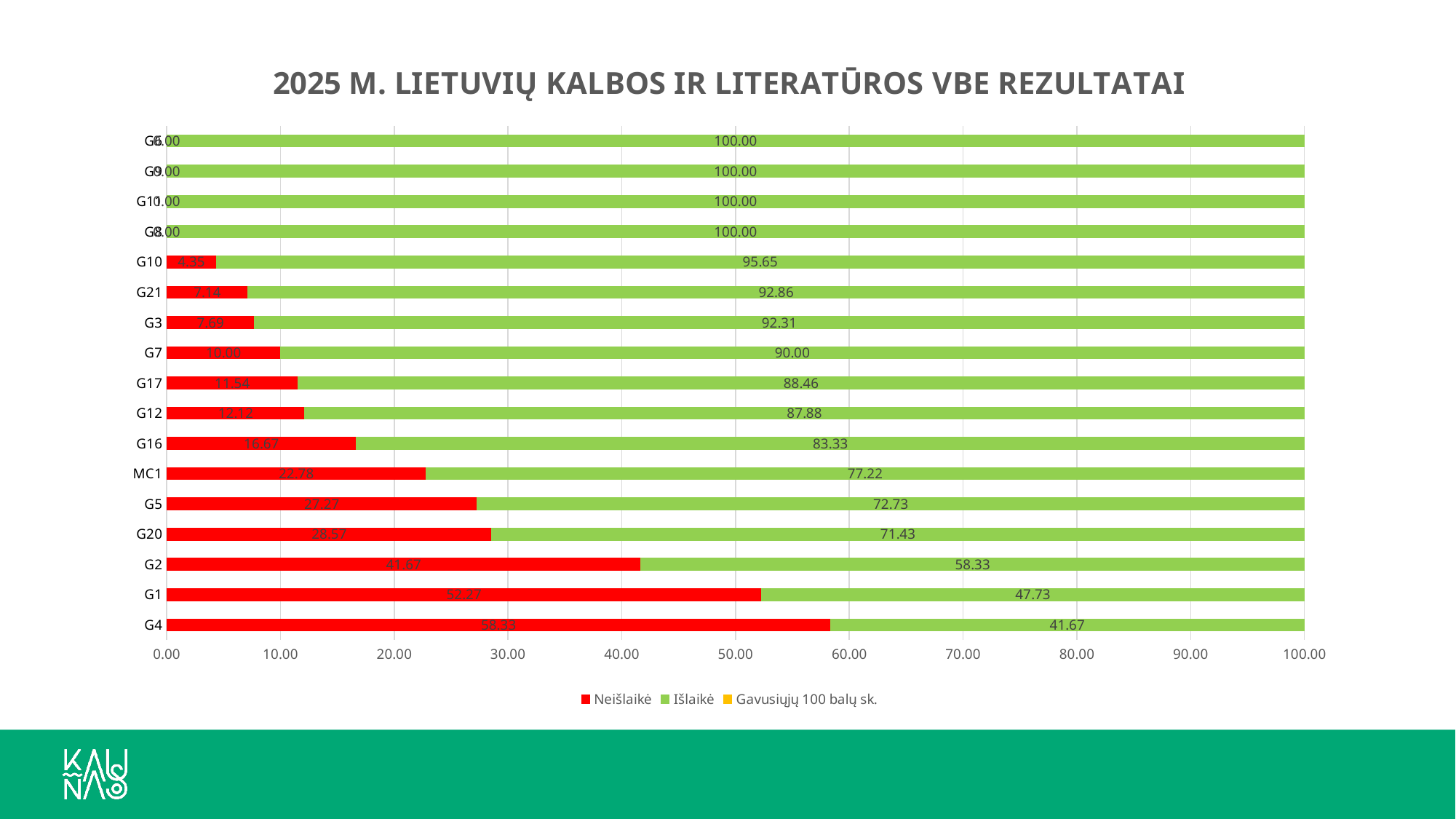
What is the Neišlaikė value for G4? 58.33 What is the Neišlaikė value for MC1? 22.78 What is the Išlaikė value for G10? 95.65 Which category has the highest Neišlaikė value? G4 What is the Išlaikė value for G1? 47.73 What is the difference between the Išlaikė and Neišlaikė values for G2? 16.66 Is the Neišlaikė value for G17 greater or less than 20.00? less What kind of chart is shown on the slide? Stacked bar chart Which has the larger Neišlaikė value, G5 or G20? G20 Which category has the lowest Išlaikė value? G4 What is the total of the stacked bar for G16? 100.00 How many series does the legend list? 3